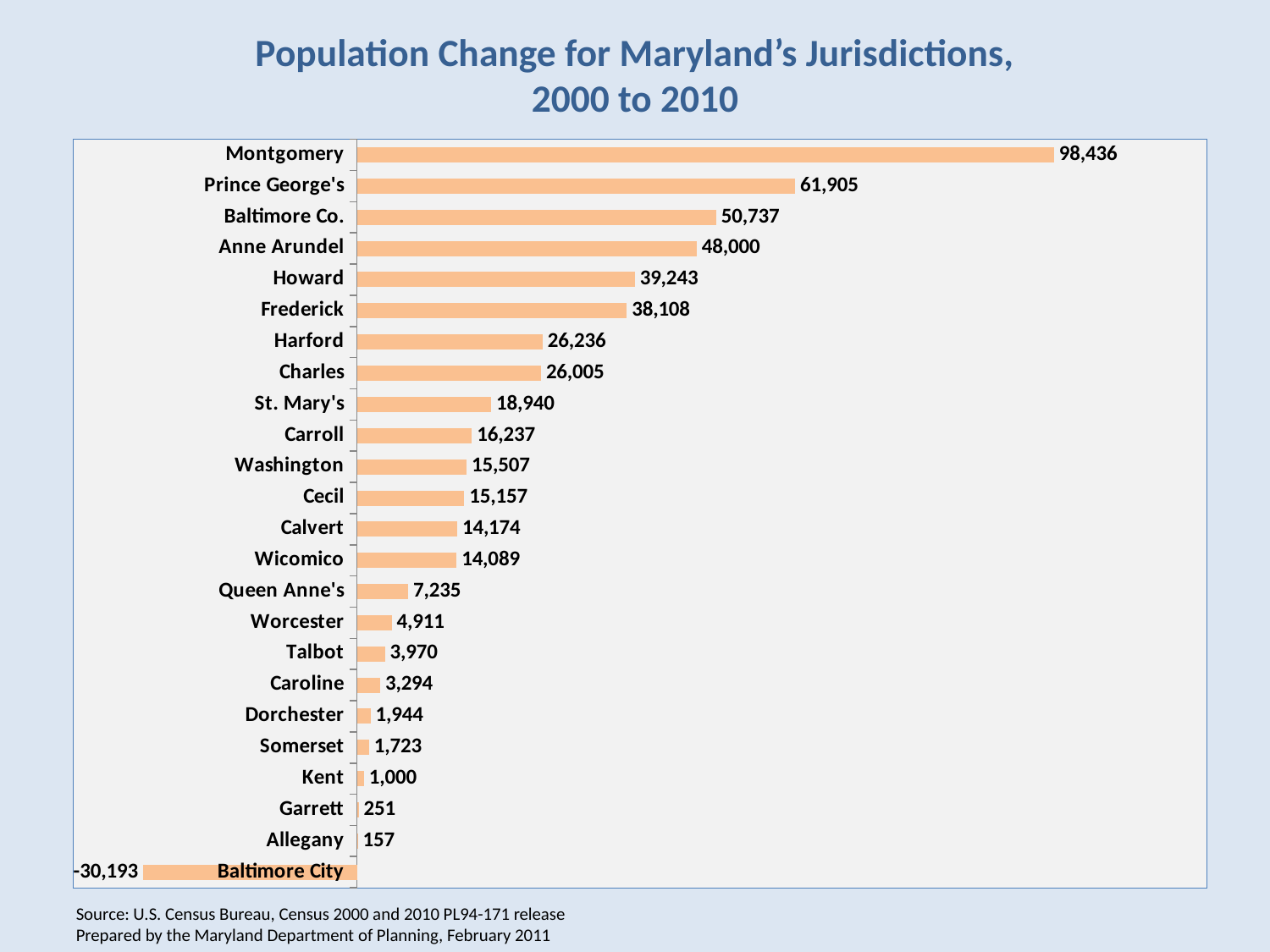
What is the population change shown for Montgomery? 98,436 Which jurisdiction has the lowest population change? Baltimore City What is the population change shown for Wicomico? 14,089 What is the difference between the population change for Howard and Frederick? 1,135 Which jurisdiction has the highest population change? Montgomery What is the population change shown for Baltimore City? -30,193 What is the title of the chart? Population Change for Maryland's Jurisdictions, 2000 to 2010 What kind of chart is shown on the slide? Bar chart Which has a larger population change, Anne Arundel or Howard? Anne Arundel Which has a larger population change, Kent or Garrett? Kent How many jurisdictions are shown in the chart? 24 What is the difference between the population change for Montgomery and Prince George's? 36,531